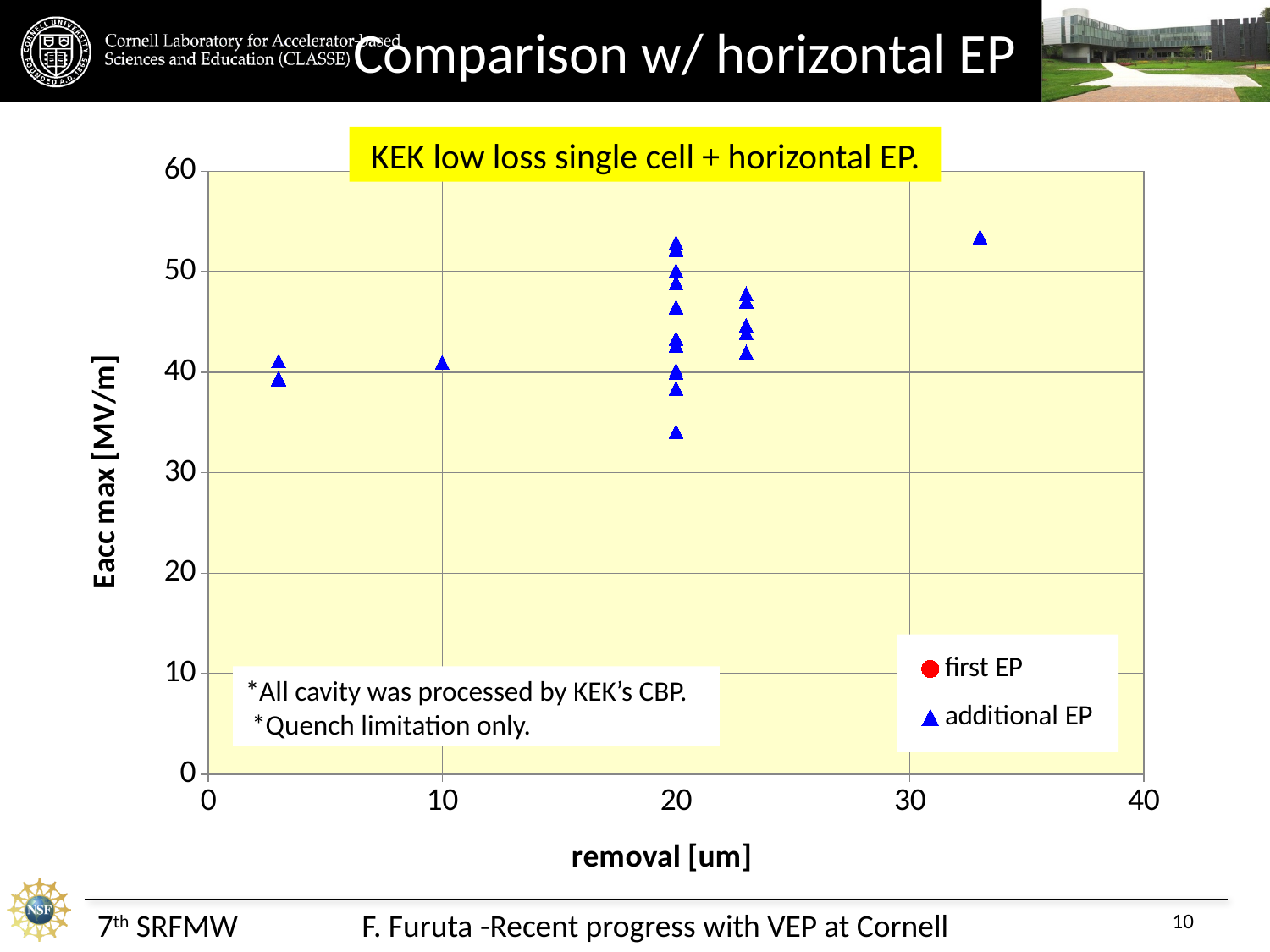
Is the Eacc max value of the point at about 33 um removal greater or less than 50? greater What is the label of the y axis? Eacc max [MV/m] What kind of chart is shown on the slide? scatter chart Which has the higher Eacc max: the point at about 33 um removal or the point at 10 um removal? the point at about 33 um removal What is the title shown above the chart? KEK low loss single cell + horizontal EP. What is the maximum value shown on the y axis? 60 What is the maximum value shown on the x axis? 40 Is the highest Eacc max value among the points at about 23 um removal greater or less than 50? less Is the lowest Eacc max value among the points at 20 um removal greater or less than 40? less How many series does the legend list? 2